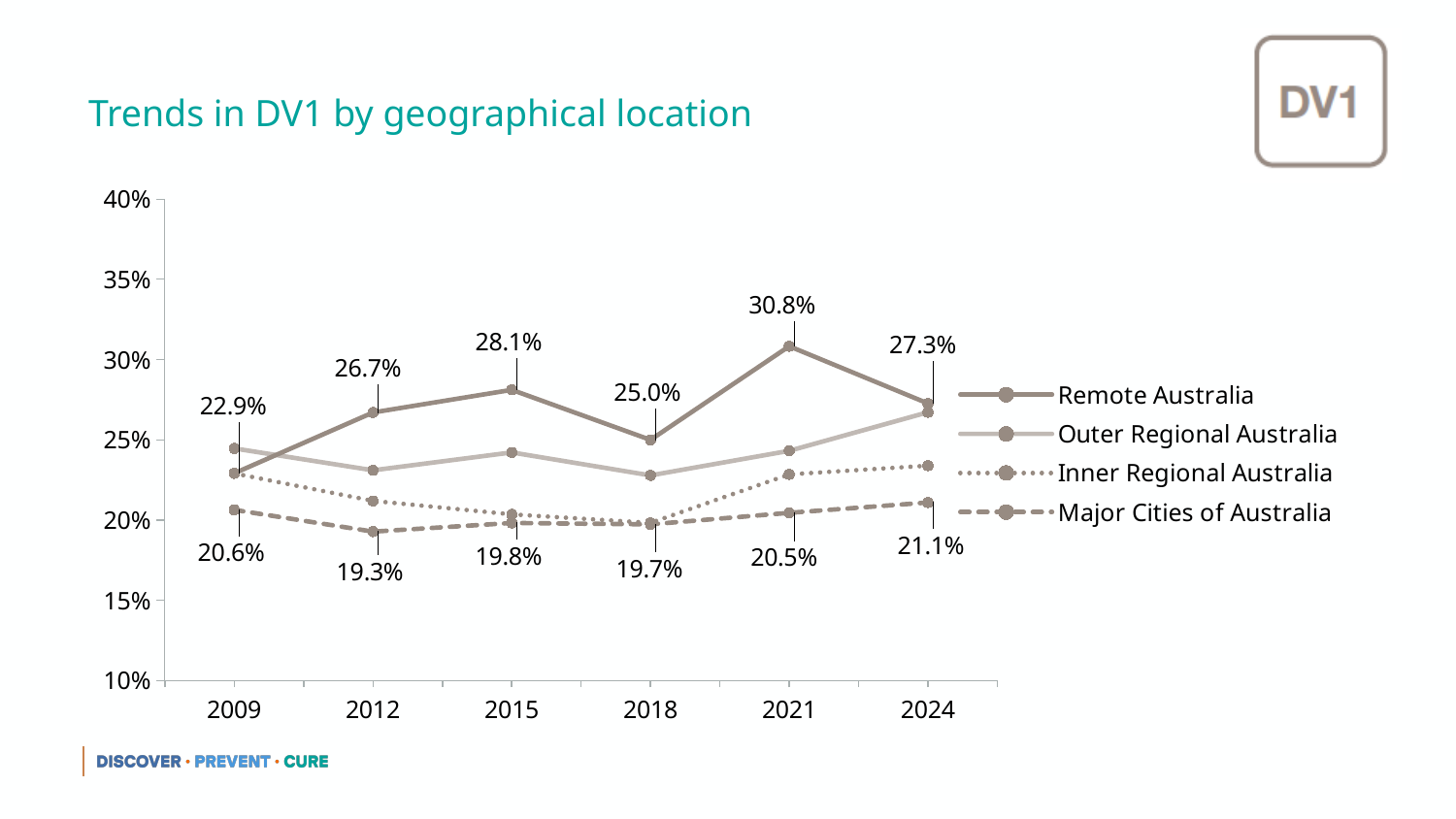
How many series does the legend list? 4 Is the value for Outer Regional Australia in 2024 greater or less than 25%? greater In which year is the Remote Australia value highest? 2021 What is the difference between the Remote Australia value in 2021 and in 2024? 3.5% What is the value for Major Cities of Australia in 2012? 19.3% In which year is the Major Cities of Australia value lowest? 2012 What is the value for Remote Australia in 2009? 22.9% What kind of chart is shown on the slide? Line chart What is the title of the chart? Trends in DV1 by geographical location What is the value for Remote Australia in 2021? 30.8% Which is larger in 2018: the value for Remote Australia or for Major Cities of Australia? Remote Australia How many years are shown on the x axis? 6